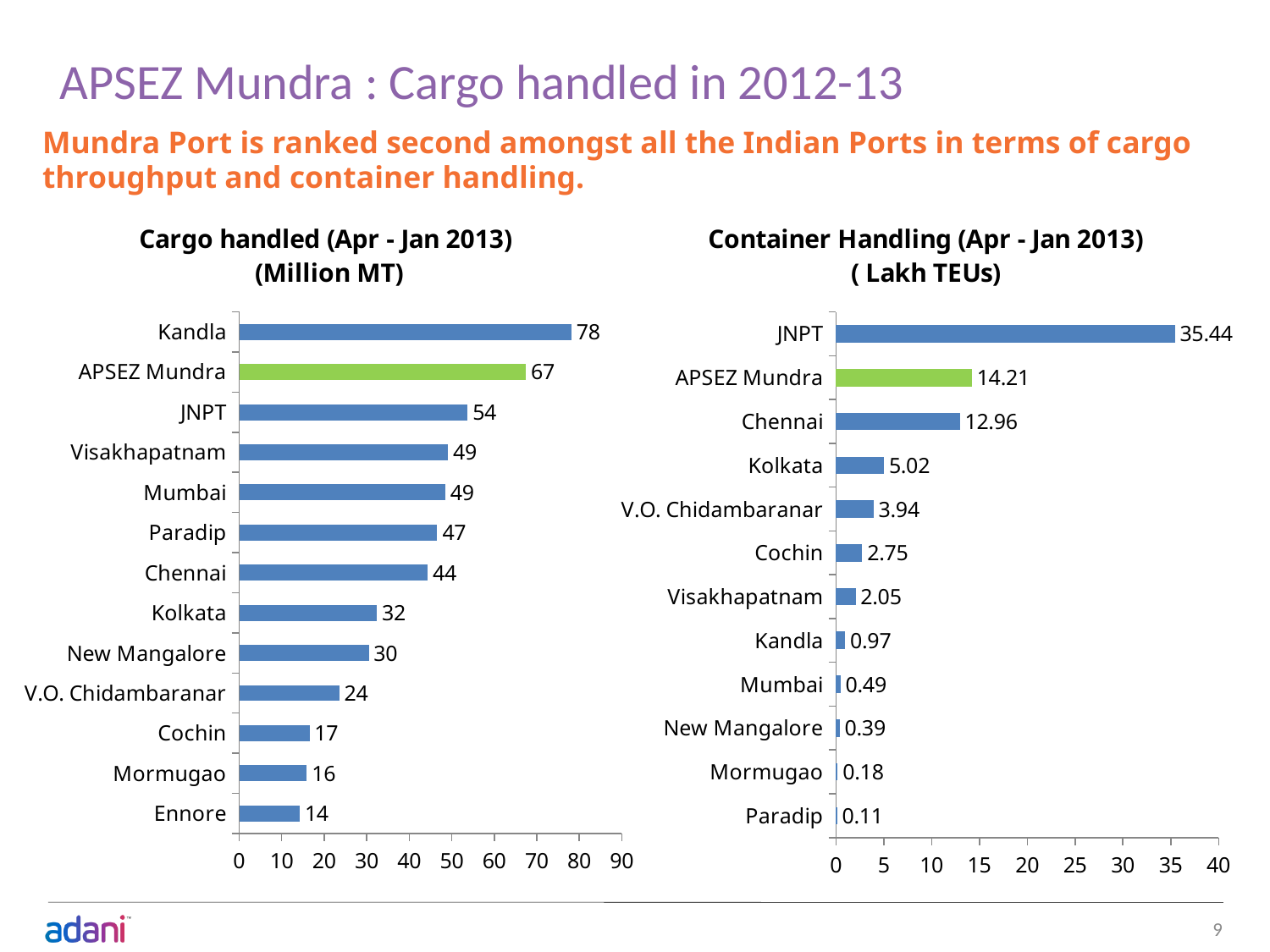
In the Cargo handled (Apr - Jan 2013) chart, which is larger, Kolkata or New Mangalore? Kolkata In the Container Handling (Apr - Jan 2013) chart, is the value for Kolkata greater or less than 10? less In the Cargo handled (Apr - Jan 2013) chart, what is the value for Ennore? 14 In the Container Handling (Apr - Jan 2013) chart, what is the value for Chennai? 12.96 In the Container Handling (Apr - Jan 2013) chart, which bar is coloured green? APSEZ Mundra In the Container Handling (Apr - Jan 2013) chart, which port has the lowest value? Paradip In the Cargo handled (Apr - Jan 2013) chart, what is the difference between Kandla and APSEZ Mundra? 11 In the Container Handling (Apr - Jan 2013) chart, what is the difference between JNPT and APSEZ Mundra? 21.23 In the Cargo handled (Apr - Jan 2013) chart, which port has the highest value? Kandla What kind of chart is the Container Handling (Apr - Jan 2013) chart? Bar chart In the Cargo handled (Apr - Jan 2013) chart, what is the value for APSEZ Mundra? 67 How many ports are shown in the Cargo handled (Apr - Jan 2013) chart? 13